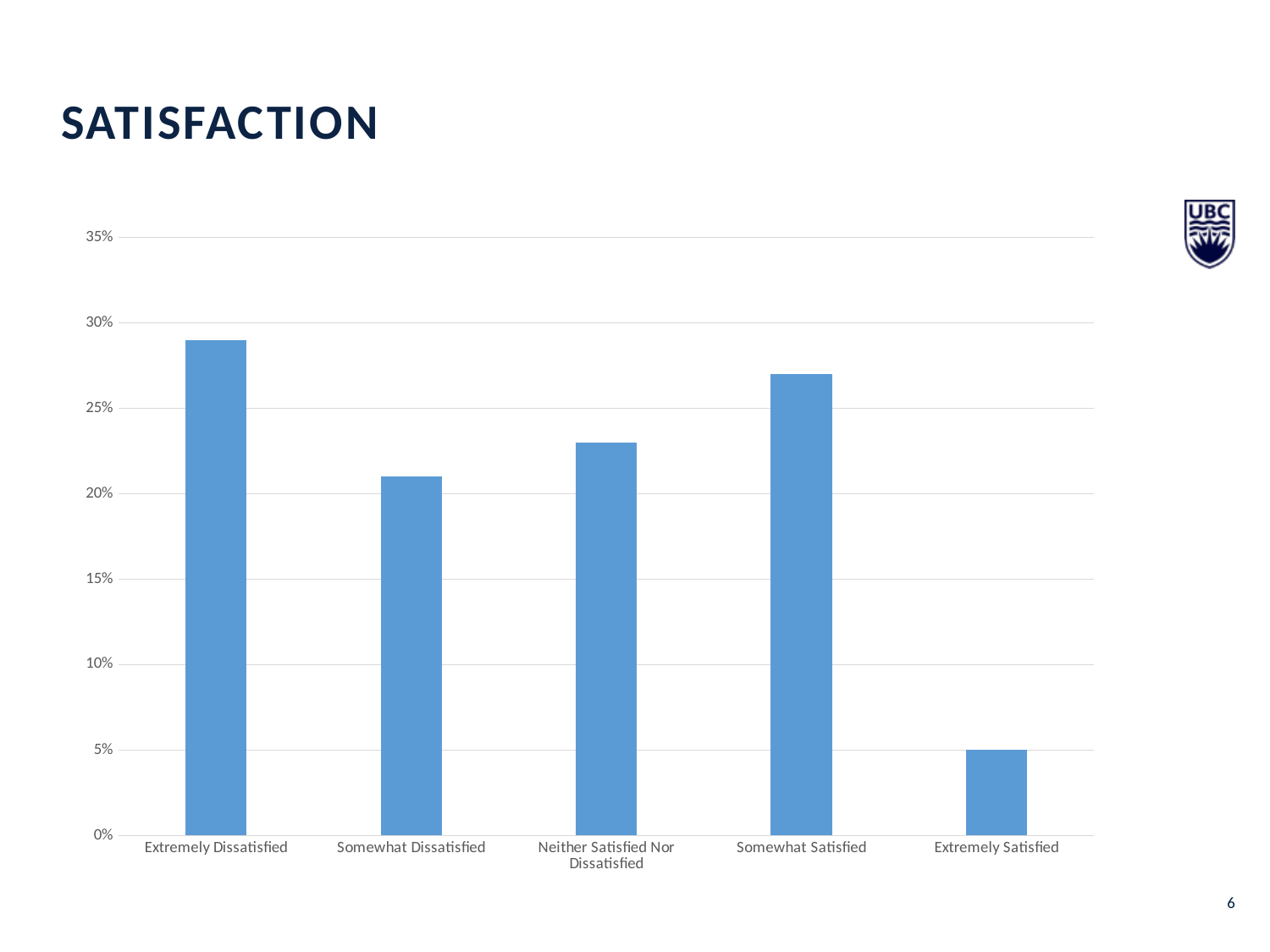
Which category has the highest value? Extremely Dissatisfied Is the value for Extremely Dissatisfied greater or less than 25%? greater Which category has the lowest value? Extremely Satisfied What is the value for Extremely Satisfied? 5% What kind of chart is shown on the slide? Bar chart Is the value for Somewhat Satisfied greater or less than 25%? greater What is the title of the slide? SATISFACTION How many categories are shown on the x axis of the chart? 5 Which is larger, the value for Neither Satisfied Nor Dissatisfied or the value for Somewhat Dissatisfied? Neither Satisfied Nor Dissatisfied Is the value for Somewhat Dissatisfied greater or less than 25%? less Which is larger, the value for Extremely Dissatisfied or the value for Somewhat Satisfied? Extremely Dissatisfied